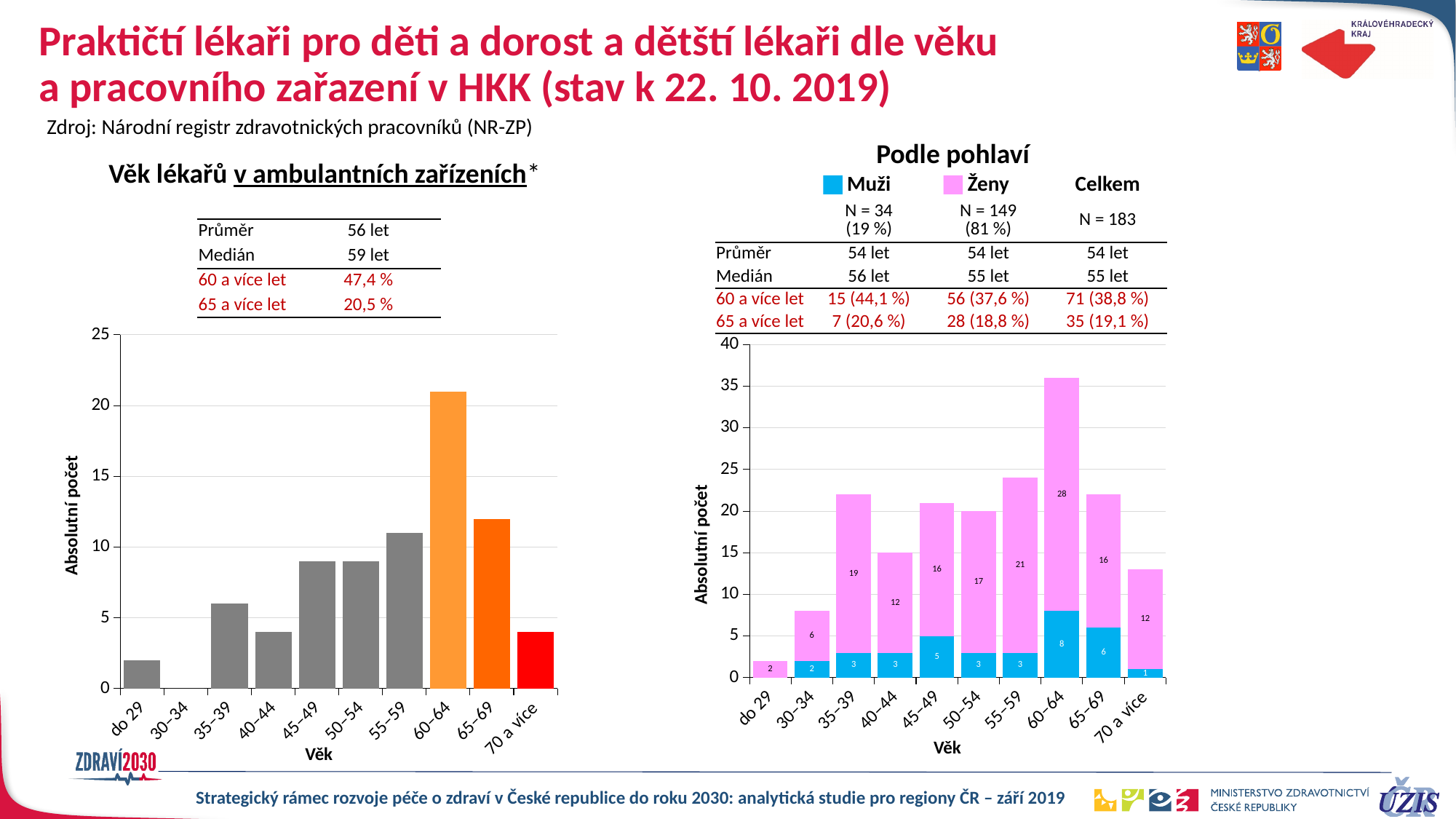
In the 'Podle pohlaví' chart, what is the value for Muži in the 45–49 age group? 5 In the 'Podle pohlaví' chart, what is the difference between the Ženy and Muži values in the 55–59 age group? 18 In the 'Věk lékařů v ambulantních zařízeních' chart, which is larger: the value for 35–39 or for 45–49? 45–49 In the 'Podle pohlaví' chart, what is the value for Muži in the '70 a více' age group? 1 In the 'Podle pohlaví' chart, what is the total of the stacked bar for the 60–64 age group? 36 What kind of chart is the 'Věk lékařů v ambulantních zařízeních' chart? bar chart In the 'Věk lékařů v ambulantních zařízeních' chart, which age group has the highest value? 60–64 How many series does the legend of the 'Podle pohlaví' chart list? 2 In the 'Podle pohlaví' chart, which age group has the lowest value for Ženy? do 29 In the 'Podle pohlaví' chart, which age group has the highest value for Ženy? 60–64 In the 'Věk lékařů v ambulantních zařízeních' chart, is the value for the 60–64 age group greater or less than 20? greater In the 'Podle pohlaví' chart, what is the value for Ženy in the 60–64 age group? 28